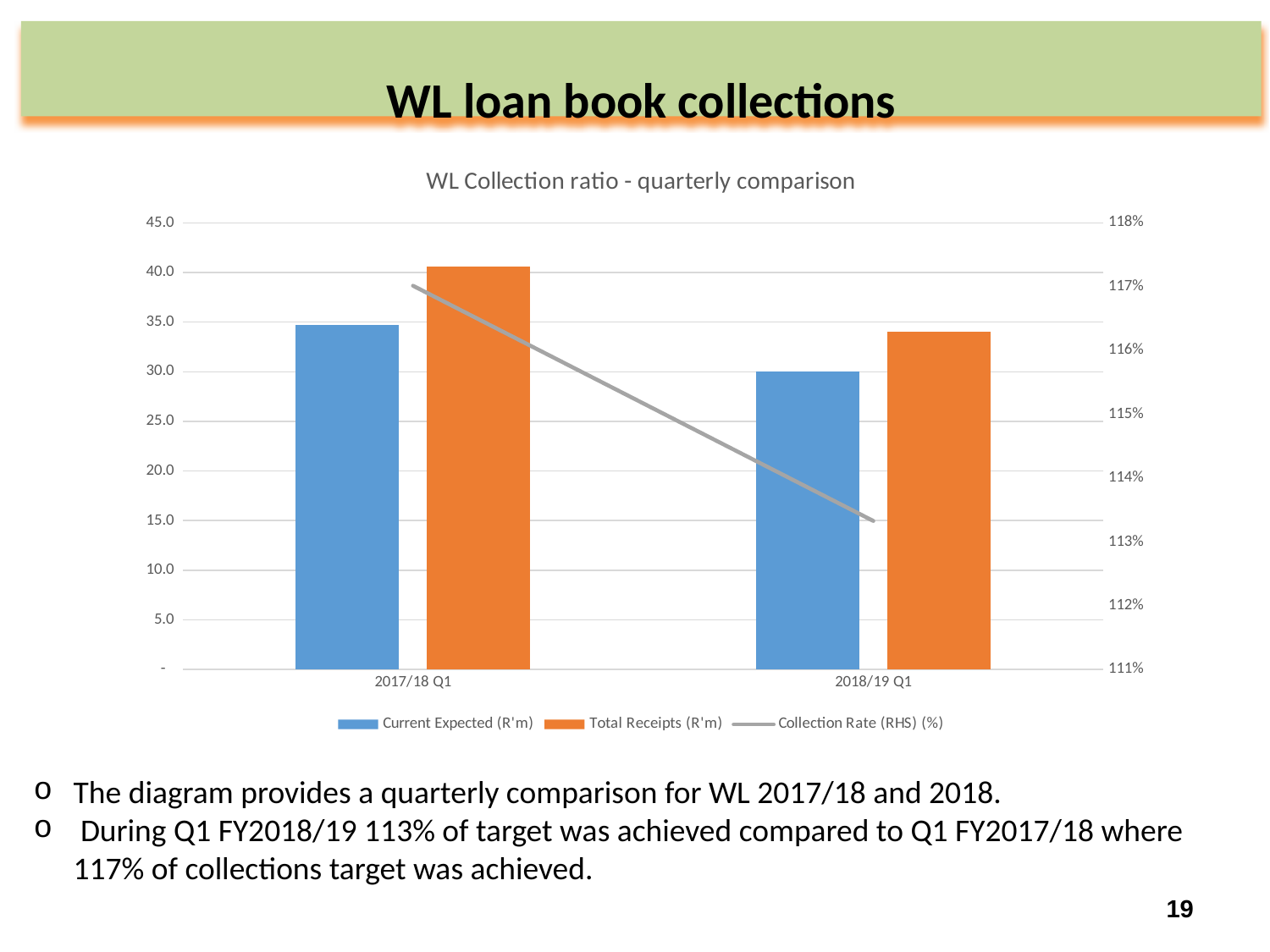
Which quarter has the lower Current Expected (R'm)? 2018/19 Q1 Which quarter has the higher Total Receipts (R'm)? 2017/18 Q1 What kind of chart is this? Combination bar and line chart Is the Current Expected (R'm) value for 2017/18 Q1 greater or less than 30.0? greater What is the title of the chart? WL Collection ratio - quarterly comparison Does the Collection Rate rise or fall from 2017/18 Q1 to 2018/19 Q1? Fall Is the Collection Rate for 2018/19 Q1 greater or less than 114%? less How many quarters (categories) are shown on the x axis? 2 Which series is plotted against the right-hand axis? Collection Rate (RHS) (%) In 2017/18 Q1, which is larger: Current Expected (R'm) or Total Receipts (R'm)? Total Receipts (R'm) Is the Total Receipts (R'm) value for 2018/19 Q1 greater or less than 30.0? greater How many series does the chart legend list? 3